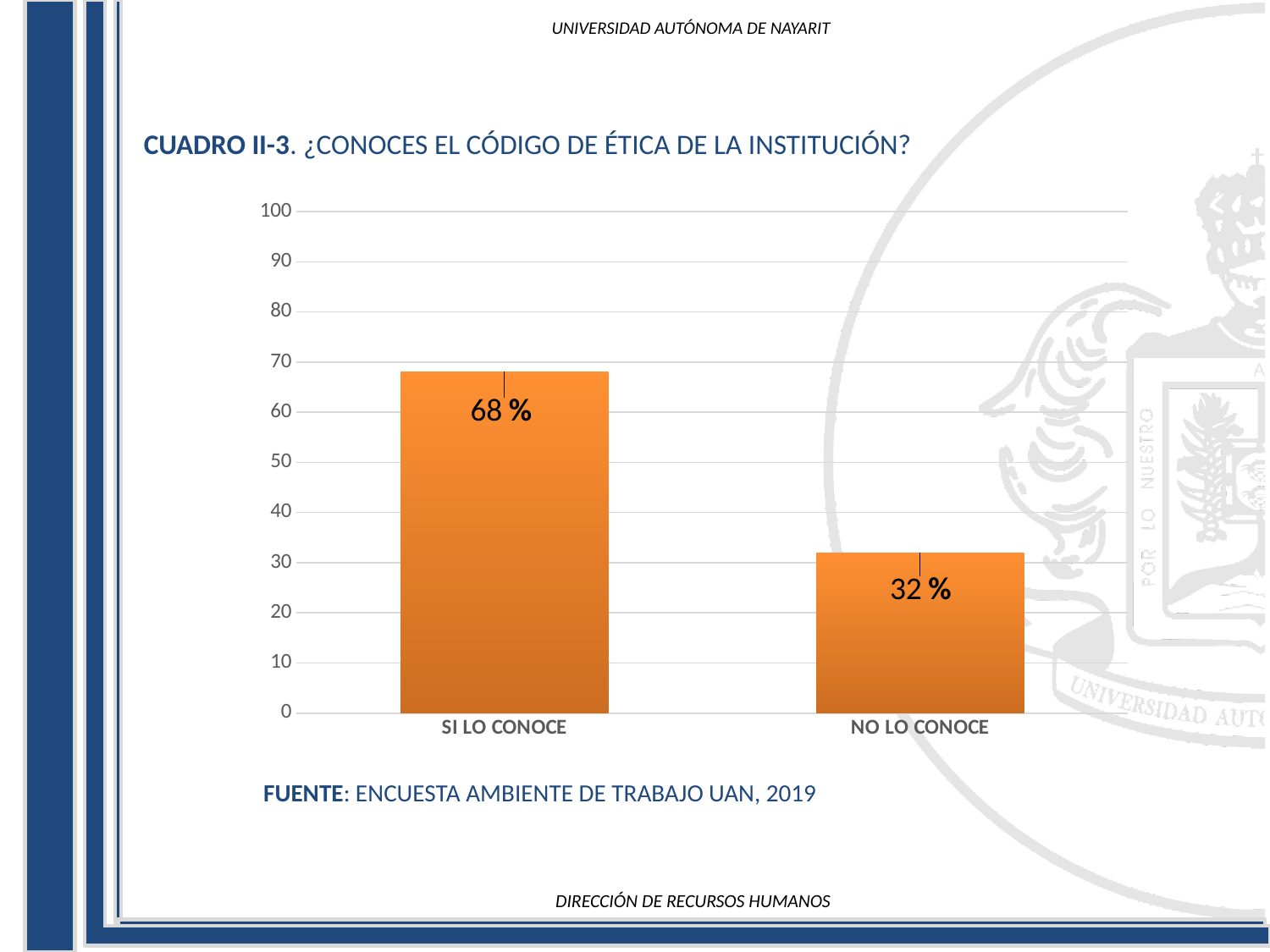
What kind of chart is shown on the slide? bar chart Which category has the lowest value? NO LO CONOCE What is the value for SI LO CONOCE? 68 % What is the value for NO LO CONOCE? 32 % Is the value for NO LO CONOCE greater or less than 40? less What is the maximum value shown on the vertical axis? 100 What source is cited below the chart? ENCUESTA AMBIENTE DE TRABAJO UAN, 2019 Which is larger, the value for SI LO CONOCE or NO LO CONOCE? SI LO CONOCE Is the value for SI LO CONOCE greater or less than 60? greater How many categories are shown on the x axis? 2 Which category has the highest value? SI LO CONOCE What is the difference between the values for SI LO CONOCE and NO LO CONOCE? 36 %